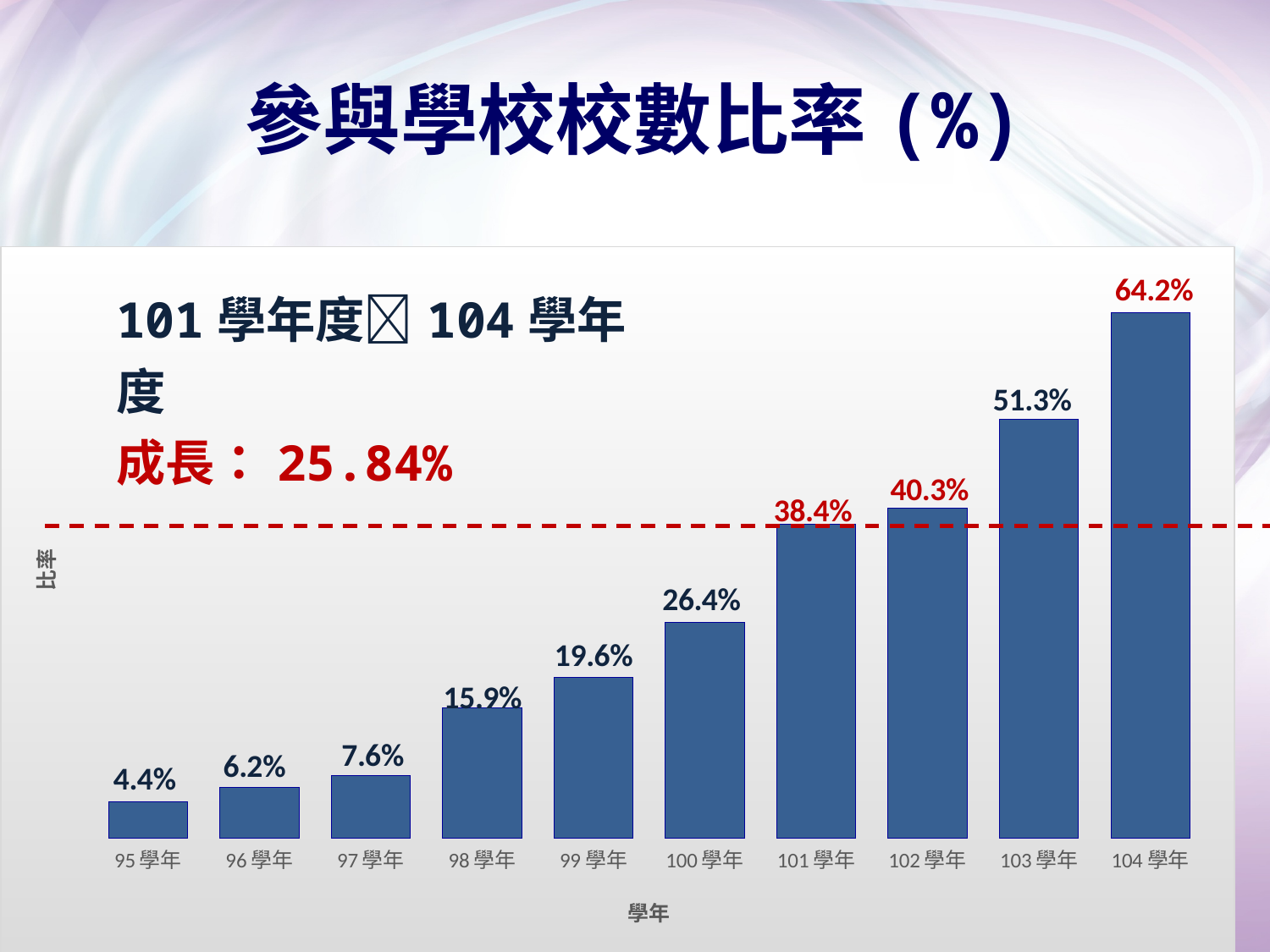
What is the value for 95 學年? 4.4% Which school year has the lowest value? 95 學年 Which is larger, the value for 99 學年 or the value for 97 學年? 99 學年 How many school years are shown on the x axis? 10 What is the value for 102 學年? 40.3% What is the difference between the values for 104 學年 and 103 學年? 12.9% Which school year has the highest value? 104 學年 What growth figure is printed in red on the chart for 101 學年度 to 104 學年度? 25.84% What is the difference between the values for 101 學年 and 100 學年? 12.0% What kind of chart is shown on the slide? bar chart What is the value for 98 學年? 15.9% Do the values rise or fall from 95 學年 to 104 學年? rise